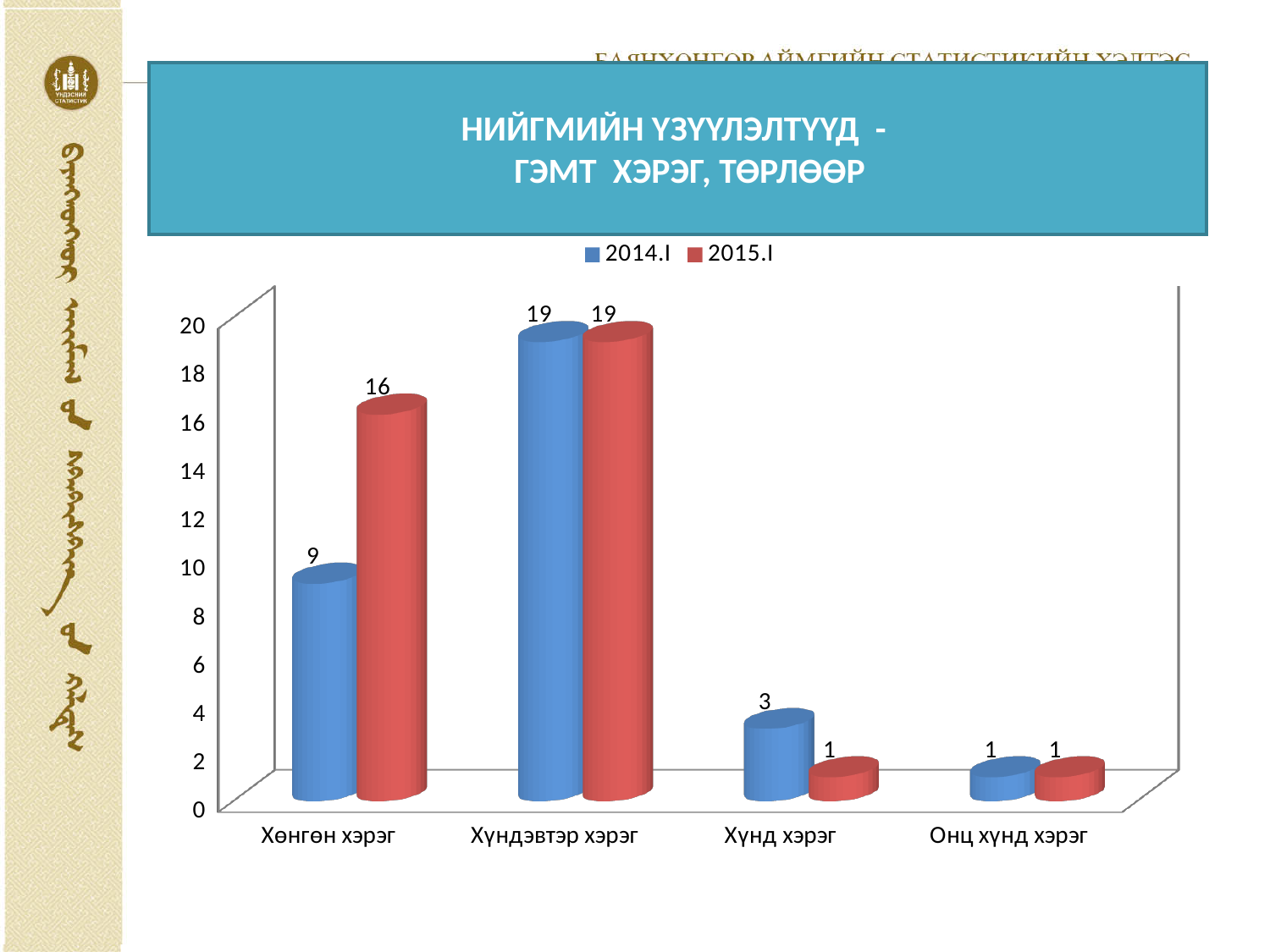
What colour are the bars for the 2015.I series? Red What is the value for Хөнгөн хэрэг in the 2014.I series? 9 What is the value for Хүнд хэрэг in the 2014.I series? 3 Which category has the lowest value in the 2014.I series? Онц хүнд хэрэг What is the value for Хүндэвтэр хэрэг in the 2015.I series? 19 What is the value for Хөнгөн хэрэг in the 2015.I series? 16 For Хүнд хэрэг, which series has the larger value, 2014.I or 2015.I? 2014.I How many series does the legend list? 2 What is the difference between the 2015.I and 2014.I values for Хөнгөн хэрэг? 7 What kind of chart is shown on the slide? Bar chart How many categories are shown on the x axis? 4 Which category has the highest value in the 2015.I series? Хүндэвтэр хэрэг